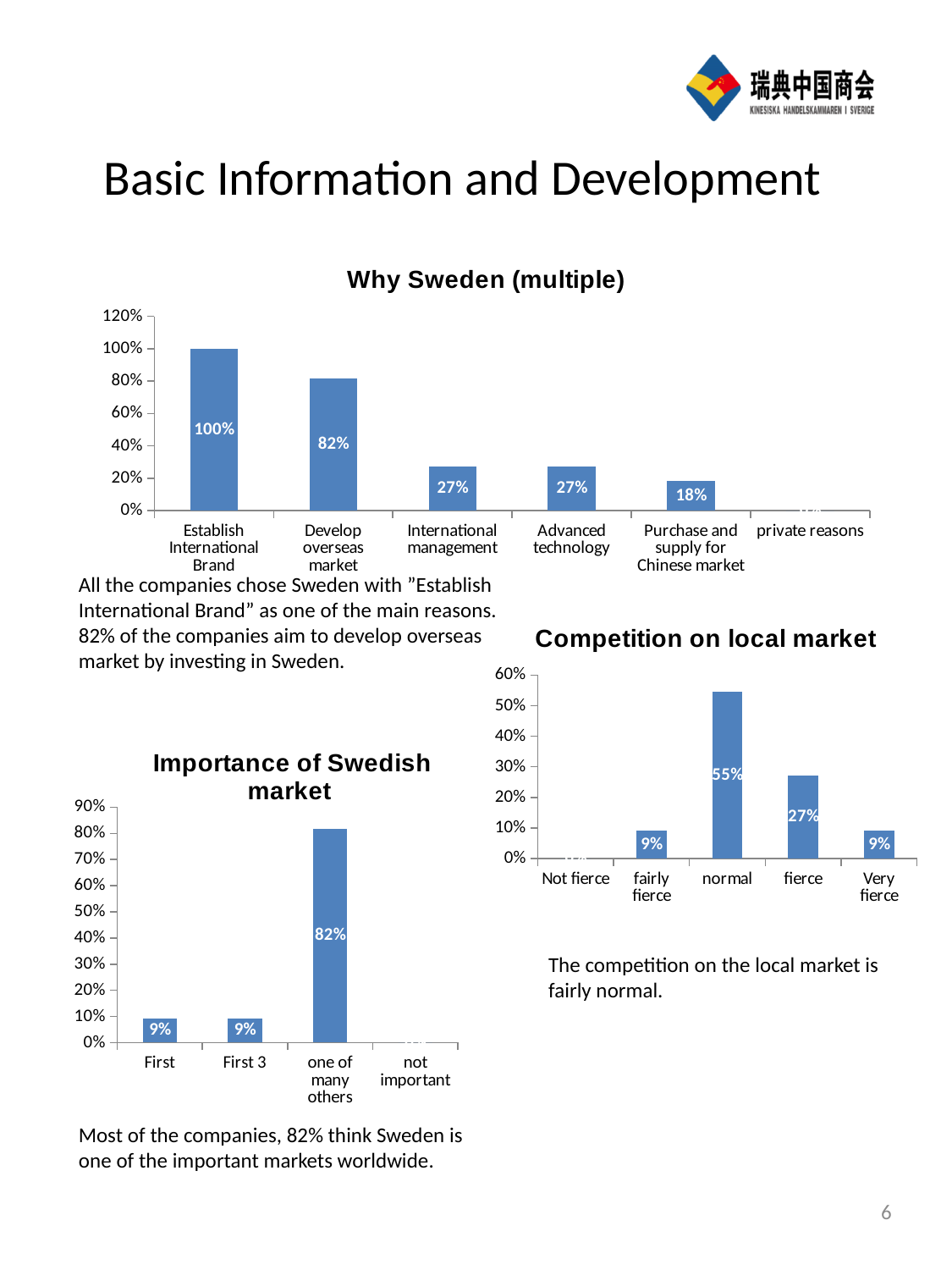
In the 'Importance of Swedish market' chart, which category has the highest value? one of many others In the 'Importance of Swedish market' chart, what is the value for 'one of many others'? 82% In the 'Why Sweden (multiple)' chart, which category has the highest value? Establish International Brand In the 'Why Sweden (multiple)' chart, what is the value for 'Develop overseas market'? 82% In the 'Why Sweden (multiple)' chart, what is the value for 'Advanced technology'? 27% In the 'Competition on local market' chart, what is the difference between 'normal' and 'fierce'? 28% In the 'Why Sweden (multiple)' chart, how many categories are shown on the x axis? 6 In the 'Competition on local market' chart, which is larger, 'fierce' or 'Very fierce'? fierce In the 'Competition on local market' chart, what is the value for 'normal'? 55% What type of chart is the 'Competition on local market' chart? Bar chart In the 'Why Sweden (multiple)' chart, what is the difference between 'Develop overseas market' and 'Purchase and supply for Chinese market'? 64% In the 'Importance of Swedish market' chart, how many categories are shown on the x axis? 4